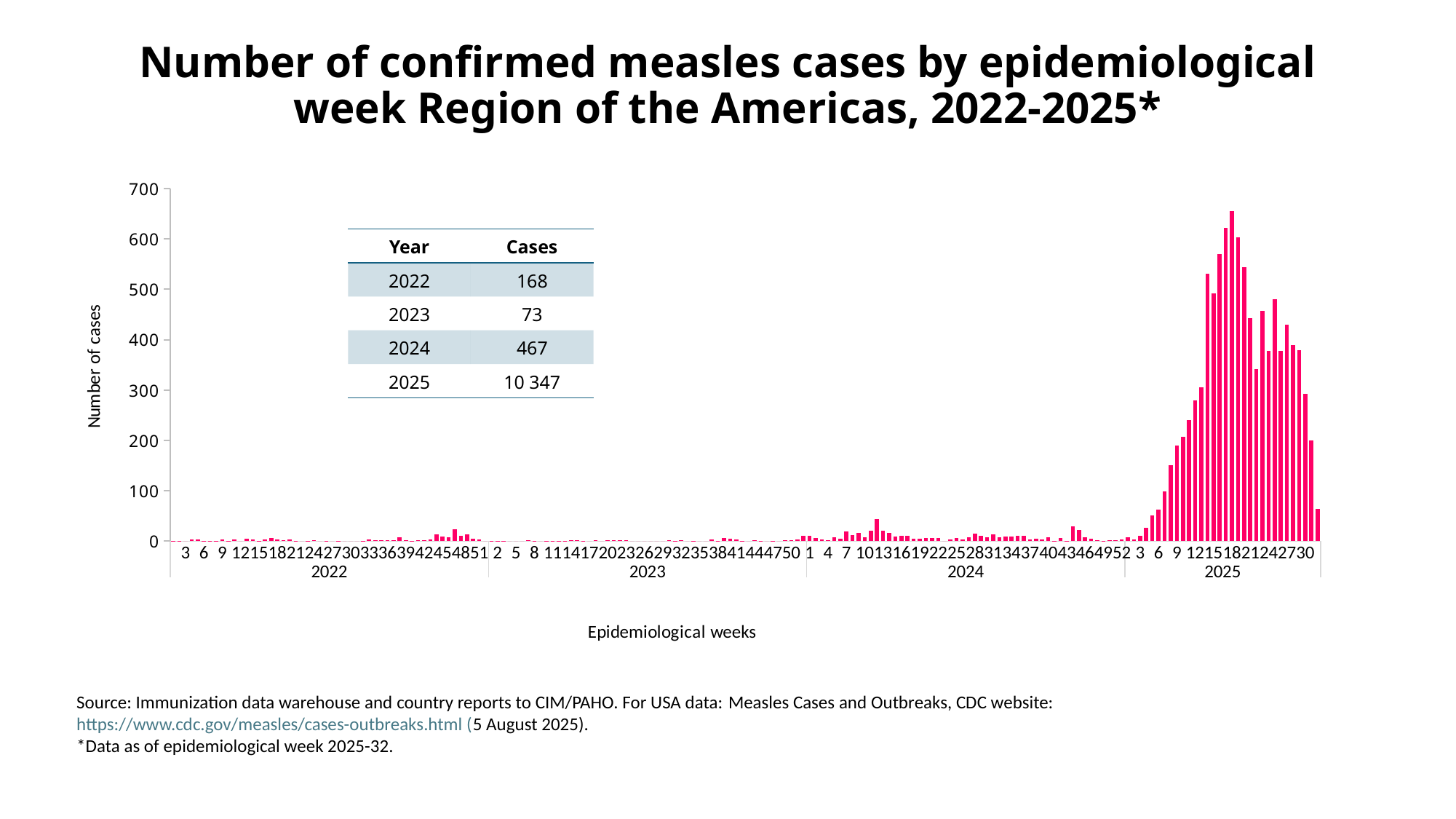
What kind of chart is shown on the slide? Bar chart Using the table in the chart, how many more cases were there in 2024 than in 2022? 299 According to the table inset in the chart, how many cases were reported in 2022? 168 What is the label on the vertical axis of the chart? Number of cases Which year in the table has the highest number of cases? 2025 Using the table in the chart, which year had more cases, 2022 or 2023? 2022 Which year in the table has the lowest number of cases? 2023 Are the weekly bars for 2023 greater or less than 100 cases? less What is the title of the chart? Number of confirmed measles cases by epidemiological week Region of the Americas, 2022-2025* Is the value of the tallest weekly bar in 2025 greater or less than 600? greater According to the table inset in the chart, how many cases were reported in 2025? 10 347 According to the table inset in the chart, how many cases were reported in 2023? 73